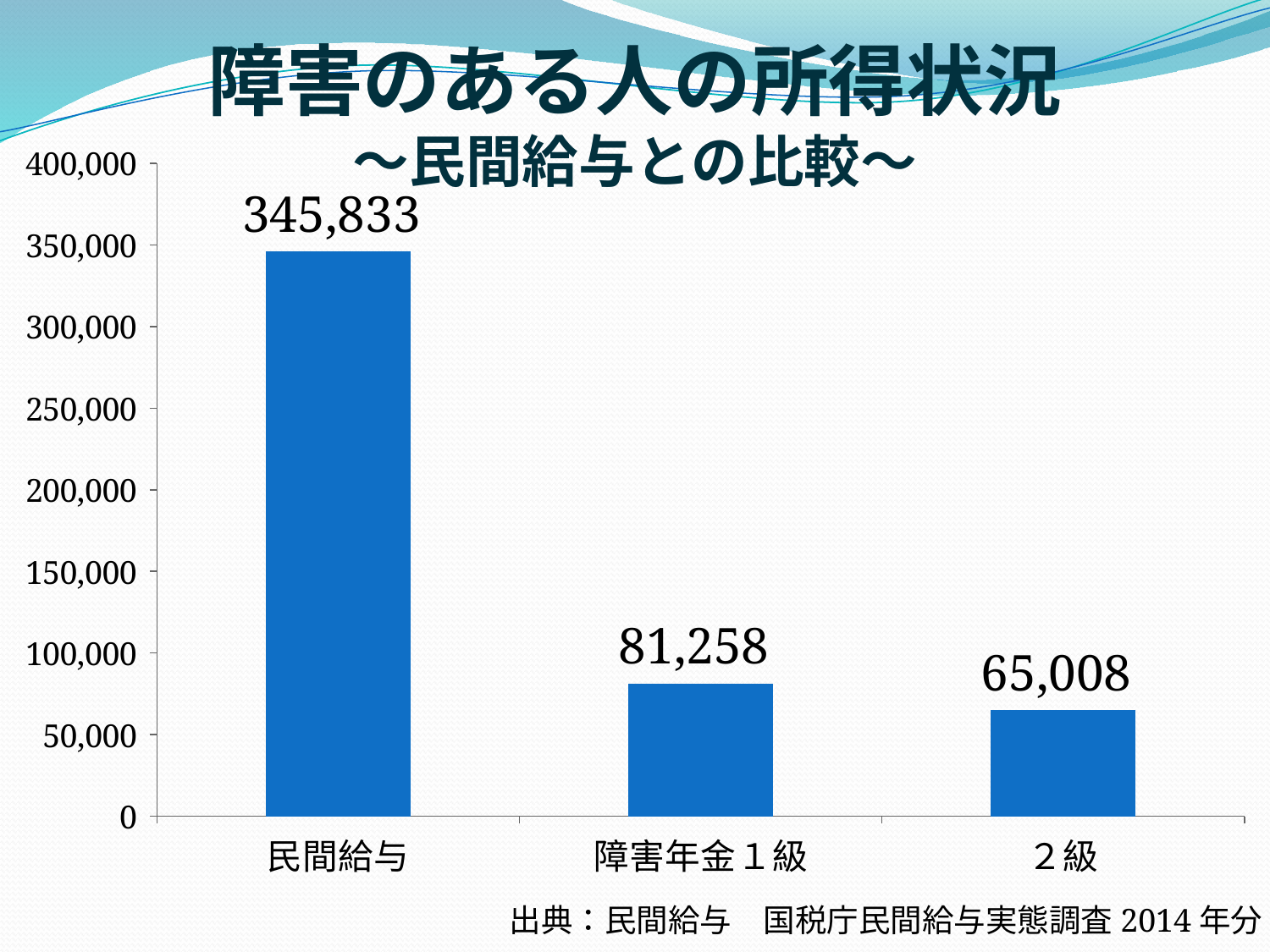
What is the difference between the values for 障害年金１級 and ２級? 16,250 What is the value for 障害年金１級? 81,258 Which category has the highest value? 民間給与 Which is larger, the value for 障害年金１級 or the value for ２級? 障害年金１級 What is the value for ２級? 65,008 What is the difference between the values for 民間給与 and 障害年金１級? 264,575 How many categories are shown on the x axis? 3 Which category has the lowest value? ２級 What kind of chart is shown on the slide? bar chart Do the values rise or fall from left to right along the x axis? fall Is the value for 障害年金１級 greater or less than 100,000? less What is the value for 民間給与? 345,833